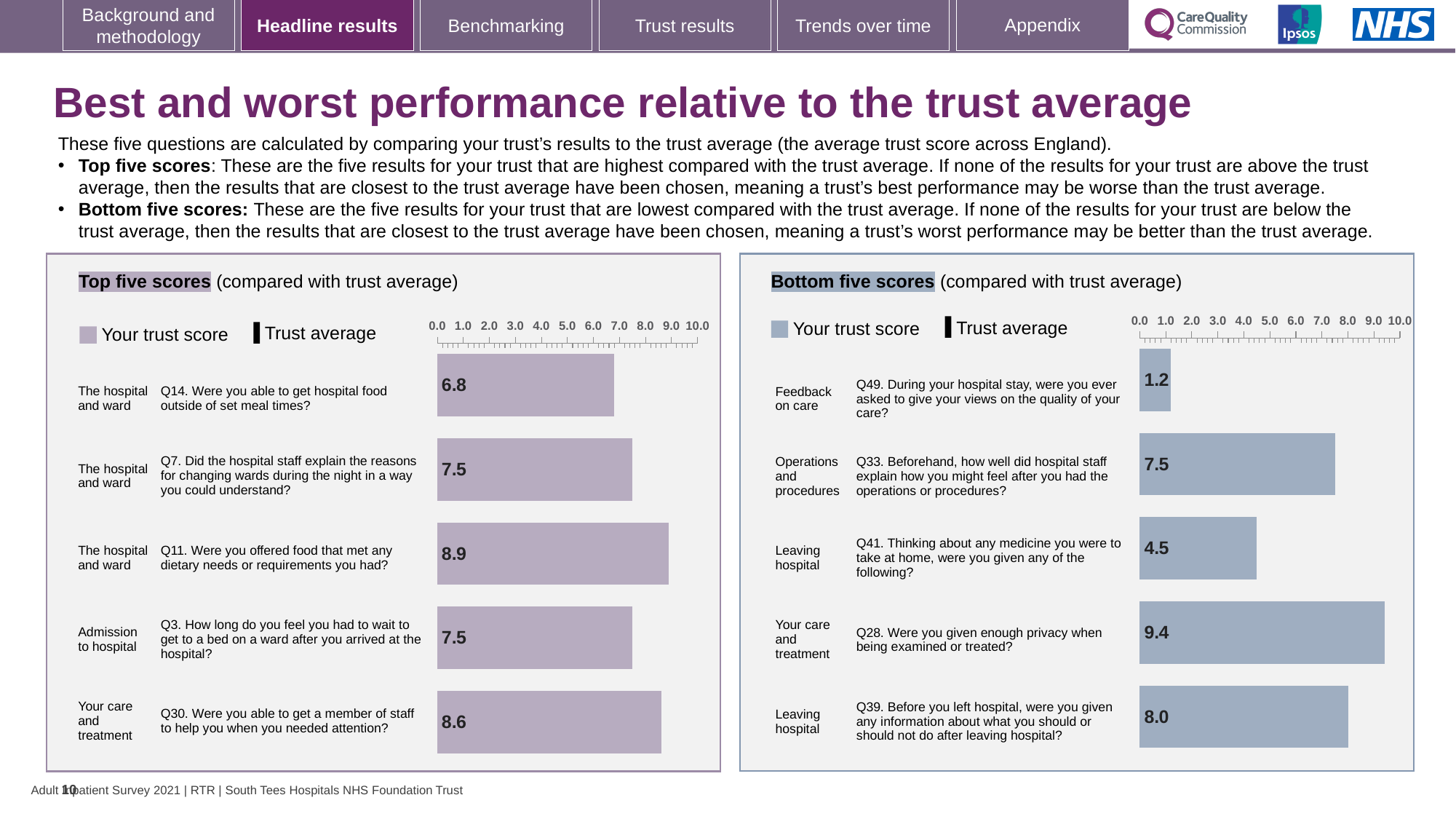
In the Top five scores chart, what is the trust score for Q14 (Were you able to get hospital food outside of set meal times?)? 6.8 In the Bottom five scores chart, which question has the lowest trust score? Q49 In the Bottom five scores chart, which has the larger score, Q33 or Q41? Q33 In the Bottom five scores chart, what is the difference between the scores for Q28 and Q39? 1.4 How many series does the legend of the Bottom five scores chart list? 2 In the Top five scores chart, which question has the highest trust score? Q11 In the Bottom five scores chart, what is the trust score for Q28 (Were you given enough privacy when being examined or treated?)? 9.4 In the Bottom five scores chart, which question has the highest trust score? Q28 How many bars are shown in the Top five scores chart? 5 In the Top five scores chart, what is the trust score for Q30 (Were you able to get a member of staff to help you when you needed attention?)? 8.6 What type of chart is the Top five scores chart? Bar chart In the Top five scores chart, what is the difference between the scores for Q11 and Q14? 2.1